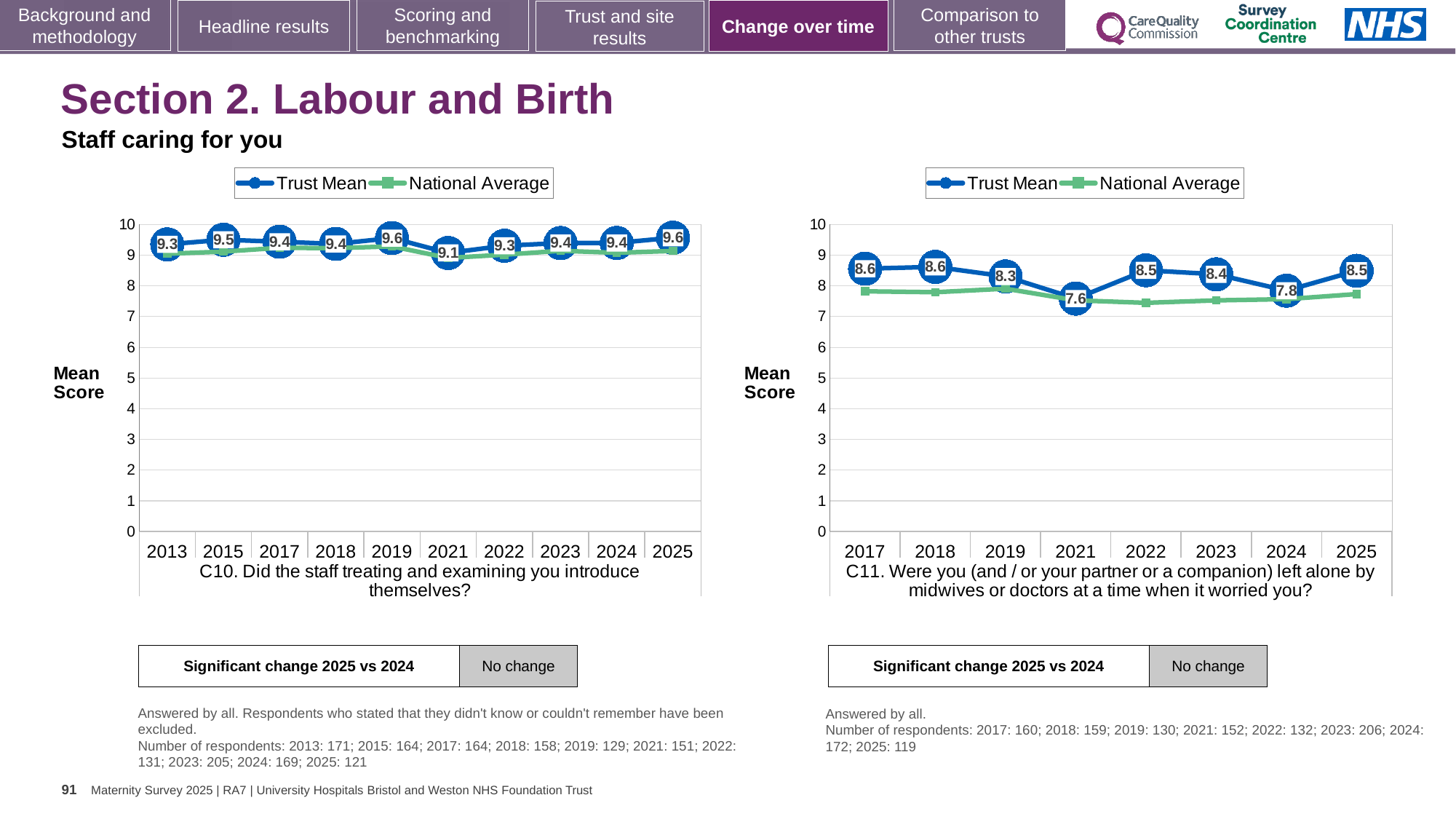
In the C11 chart on the right, what is the Trust Mean score for 2024? 7.8 In the C11 chart on the right, which year has the lowest Trust Mean score? 2021 In the C11 chart on the right, how many series does the legend list? 2 In the C11 chart on the right, what is the Trust Mean score for 2021? 7.6 In the C10 chart on the left, what is the Trust Mean score for 2025? 9.6 In the C10 chart on the left, how many years are plotted on the x axis? 10 In the C10 chart on the left, which year has the lowest Trust Mean score? 2021 In the C11 chart on the right, is the Trust Mean score for 2022 or 2024 larger? 2022 What kind of chart is the C11 chart on the right? Line chart In the C10 chart on the left, what is the difference between the Trust Mean scores for 2025 and 2021? 0.5 In the C11 chart on the right, is the National Average value for 2021 greater or less than 8? less In the C10 chart on the left, what is the Trust Mean score for 2021? 9.1